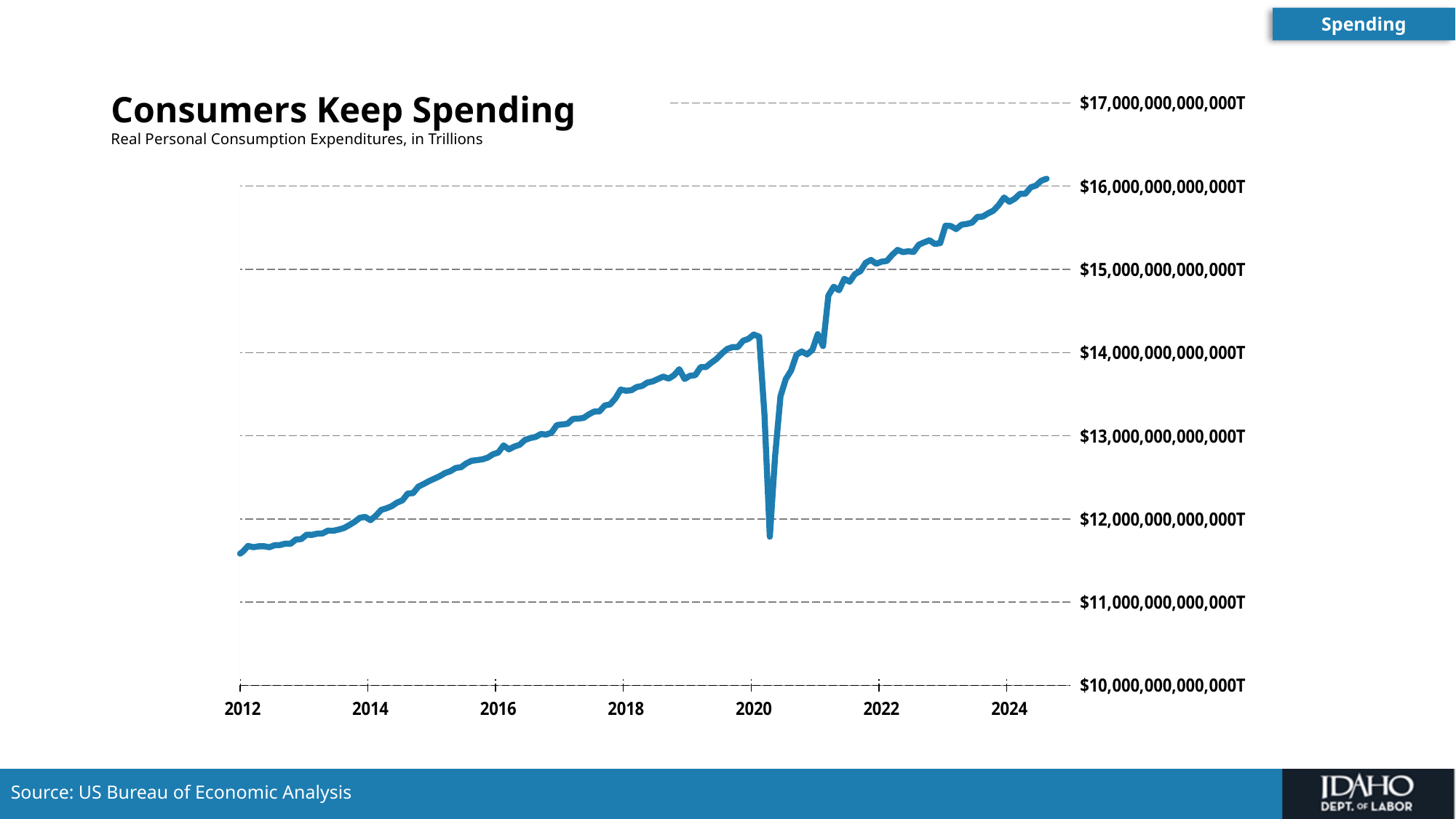
Is the value at the start of 2016 greater or less than $13,000,000,000,000T? less Is the value at the start of 2018 greater or less than $13,000,000,000,000T? greater Is the lowest point of the sharp dip in 2020 greater or less than $12,000,000,000,000T? less What is the title of the chart? Consumers Keep Spending Overall, do the values rise or fall from 2012 to 2024? rise What kind of chart is shown on the slide? line chart How many year labels are shown on the x axis? 7 Which is larger, the value at the start of 2014 or the value at the start of 2020? 2020 What is the subtitle printed under the chart title? Real Personal Consumption Expenditures, in Trillions